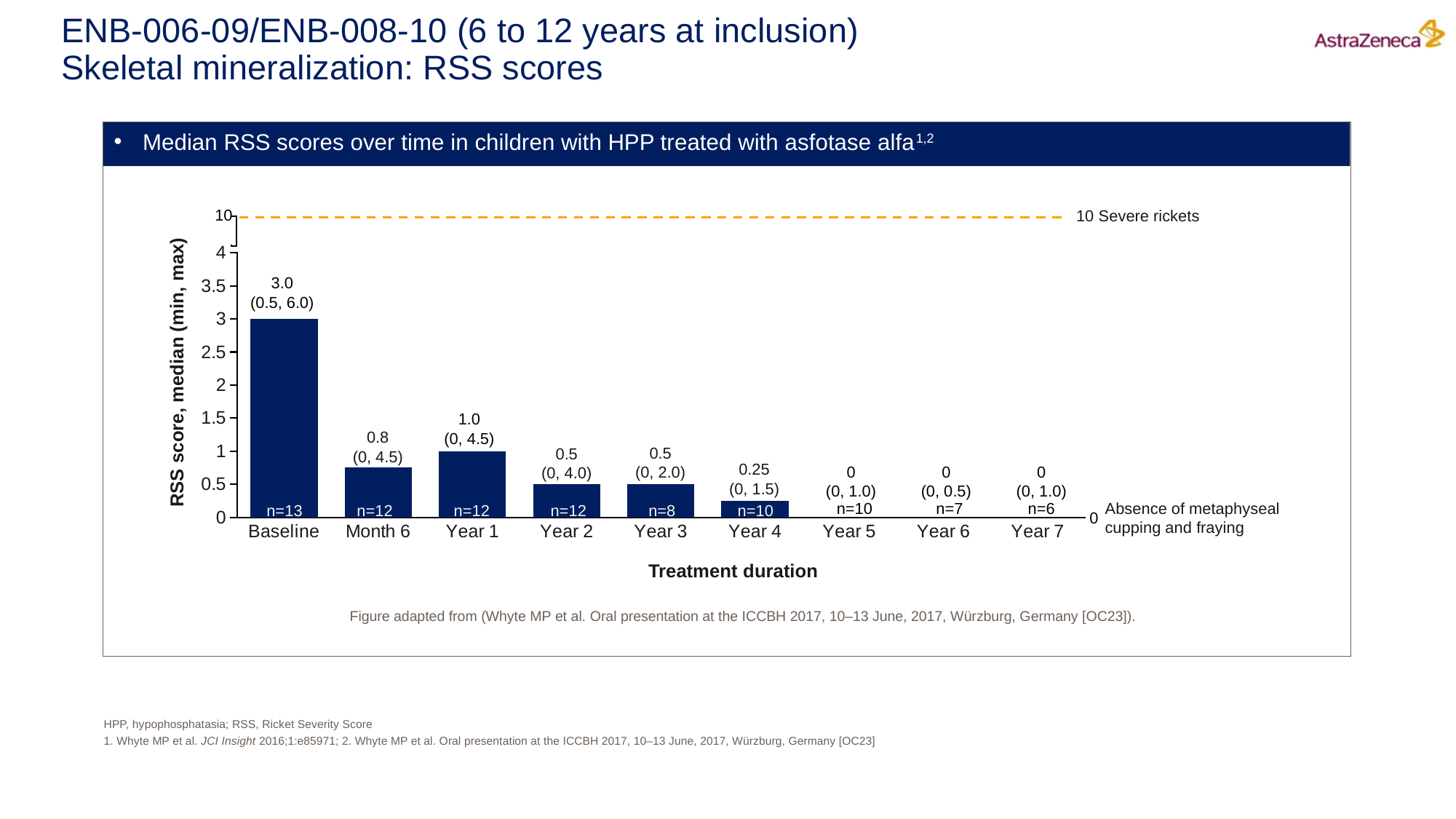
What is the median RSS score at Year 1? 1.0 How many time points are shown on the x axis? 9 What RSS score does the dashed line labelled 'Severe rickets' mark? 10 Do the median RSS scores generally rise or fall from Baseline to Year 7? Fall Which is larger, the median RSS score at Month 6 or at Year 1? Year 1 What is the median RSS score at Baseline? 3.0 What kind of chart is shown on the slide? Bar chart What is the median RSS score at Year 4? 0.25 What is the difference between the median RSS score at Baseline and at Year 1? 2.0 What is the (min, max) range shown for the Month 6 RSS score? (0, 4.5) Which time point has the highest median RSS score? Baseline How many patients (n) are shown for Year 3? n=8